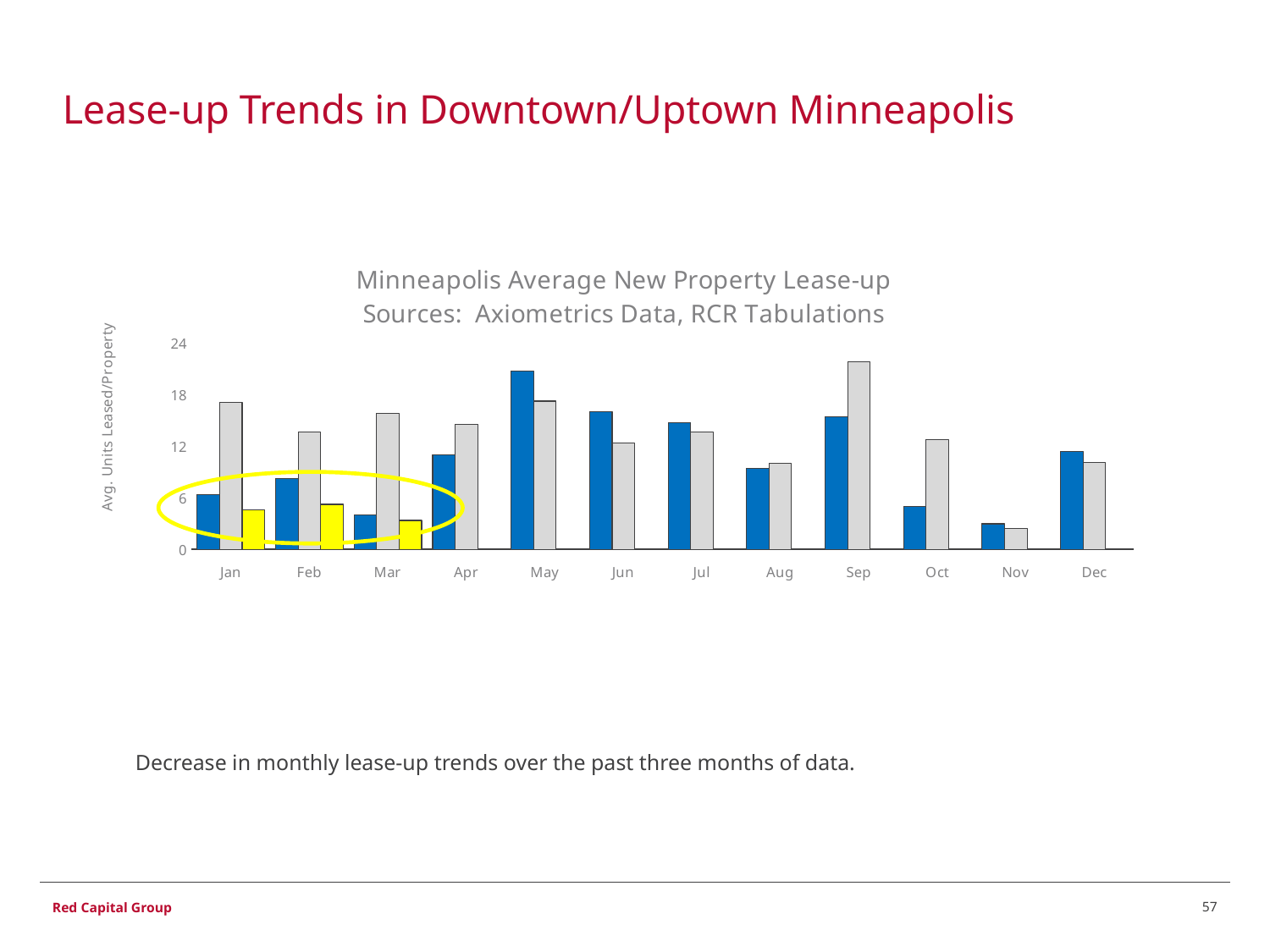
What kind of chart is shown on the slide? bar chart In which month is the blue bar the lowest? Nov Is the value of the blue bar for May greater or less than 18? greater How many months are shown on the x axis of the chart? 12 What is the title of the chart? Minneapolis Average New Property Lease-up Is the value of the blue bar for Nov greater or less than 6? less In May, which bar is taller, the blue bar or the gray bar? blue bar Do the blue bars rise or fall from Sep to Nov? fall In which month is the blue bar the highest? May In which month is the gray bar the highest? Sep What is the label on the y axis of the chart? Avg. Units Leased/Property Is the value of the gray bar for Sep greater or less than 18? greater